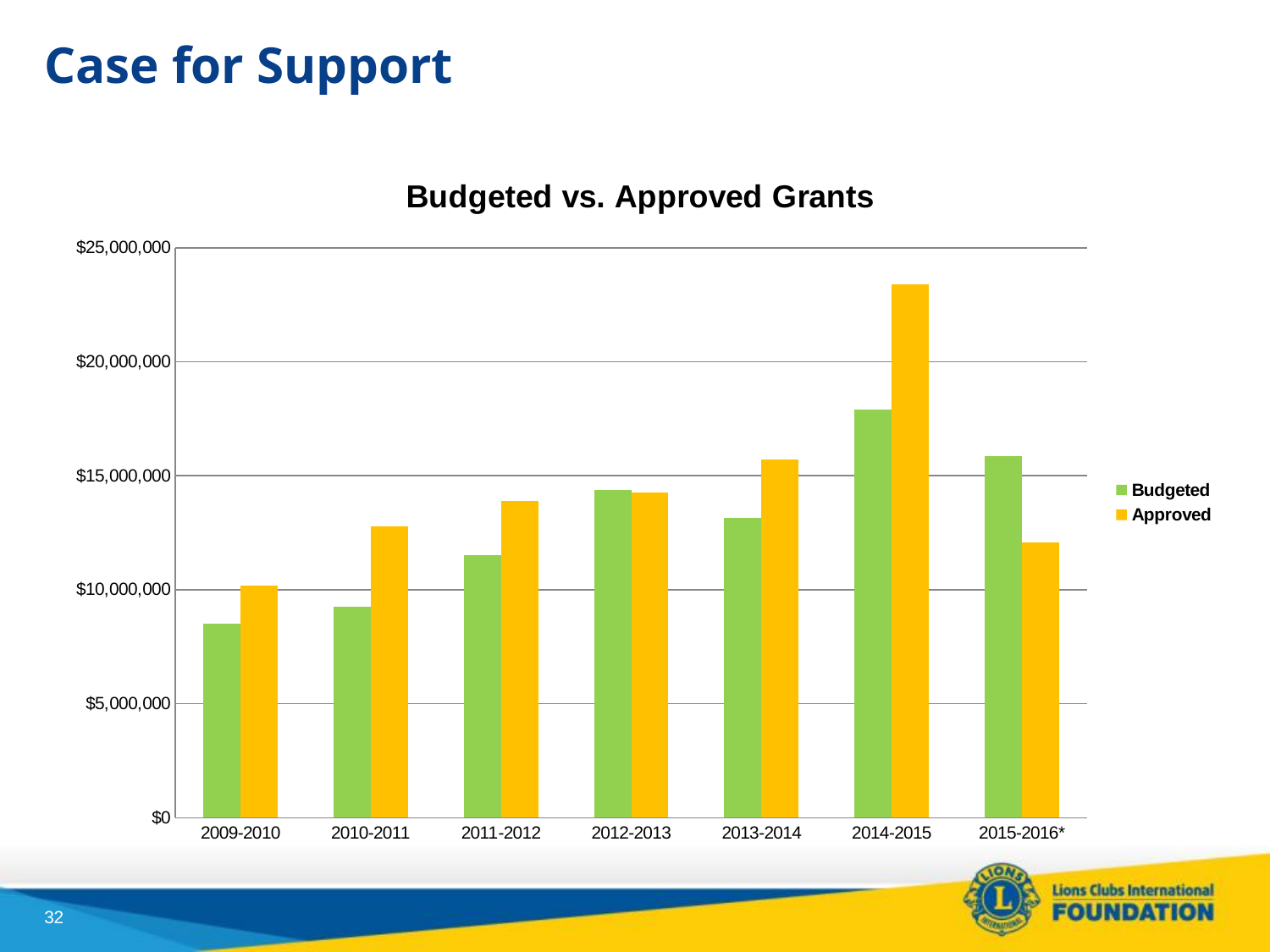
For 2010-2011, which is larger, Budgeted or Approved? Approved For 2015-2016*, which is larger, Budgeted or Approved? Budgeted Which year has the highest Approved value? 2014-2015 How many series does the legend list? 2 How many fiscal-year categories are shown on the x axis? 7 What kind of chart is shown on the slide? Bar chart Which year has the lowest Budgeted value? 2009-2010 What is the title of the chart? Budgeted vs. Approved Grants Which year has the highest Budgeted value? 2014-2015 Is the Approved value for 2014-2015 greater or less than $20,000,000? greater Is the Budgeted value for 2009-2010 greater or less than $10,000,000? less Is the Approved value for 2013-2014 greater or less than $15,000,000? greater